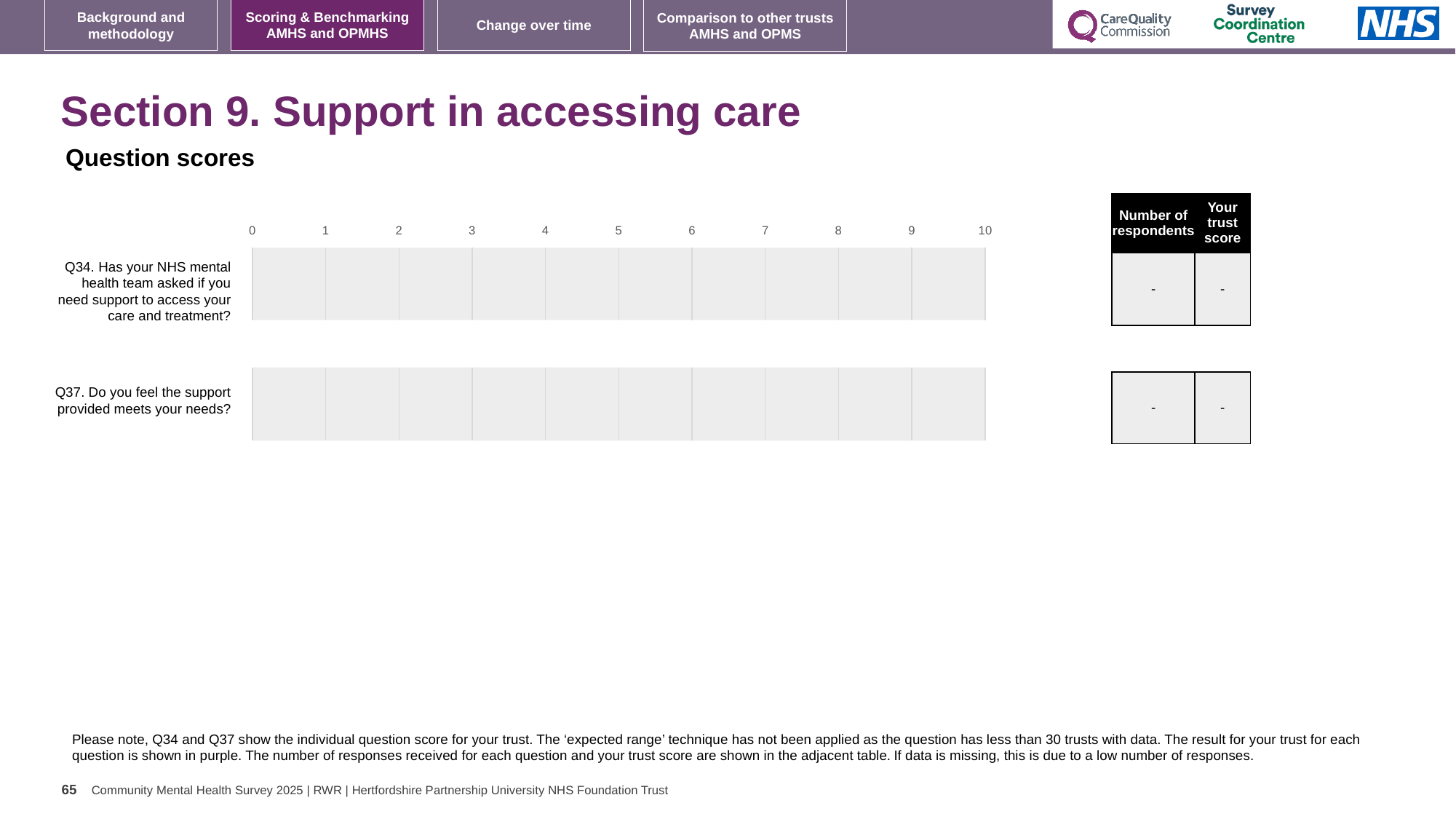
What is the highest value shown on the chart's axis? 10 What is the heading given to the chart on the slide? Question scores What kind of chart is shown on the slide? bar chart What is shown in the 'Your trust score' column for Q34? - How many questions (categories) are listed on the chart? 2 What is shown in the 'Number of respondents' column for Q37? -